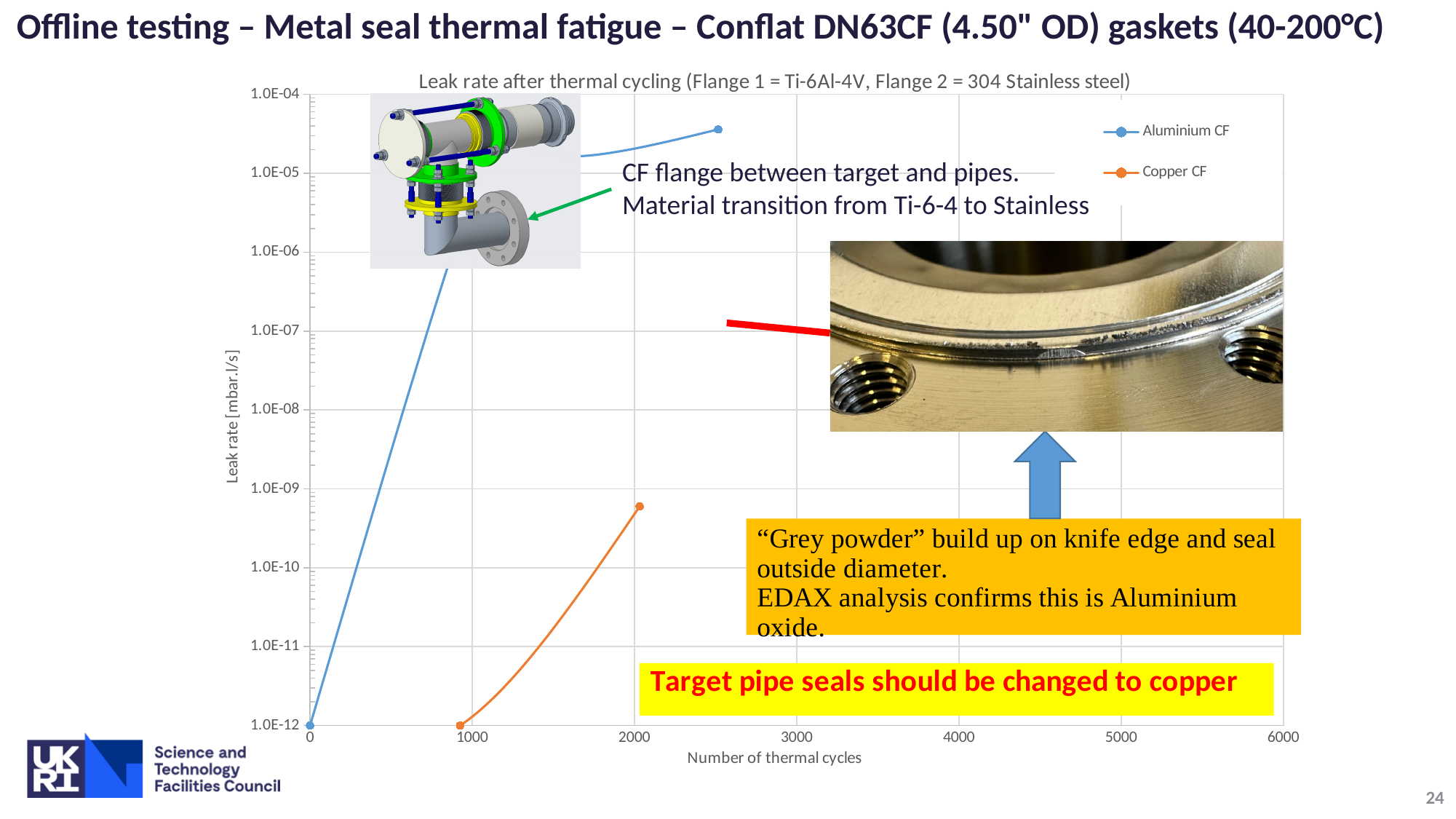
How many data points are plotted for the Copper CF series? 2 What are the two series named in the chart legend? Aluminium CF and Copper CF What is the lowest leak rate plotted for the Copper CF series? 1.0E-12 What kind of chart is shown on the slide? Line chart What is the leak rate of the Aluminium CF series at 0 thermal cycles? 1.0E-12 Is the highest leak rate plotted for Copper CF greater or less than 1.0E-08? less What is the label of the x axis of the chart? Number of thermal cycles Which series has the lower leak rate at around 2000 thermal cycles? Copper CF Which series reaches the higher leak rate on the chart, Aluminium CF or Copper CF? Aluminium CF How many series does the chart legend list? 2 Does the leak rate rise or fall as the number of thermal cycles increases? Rises Is the highest leak rate plotted for Aluminium CF greater or less than 1.0E-05? greater